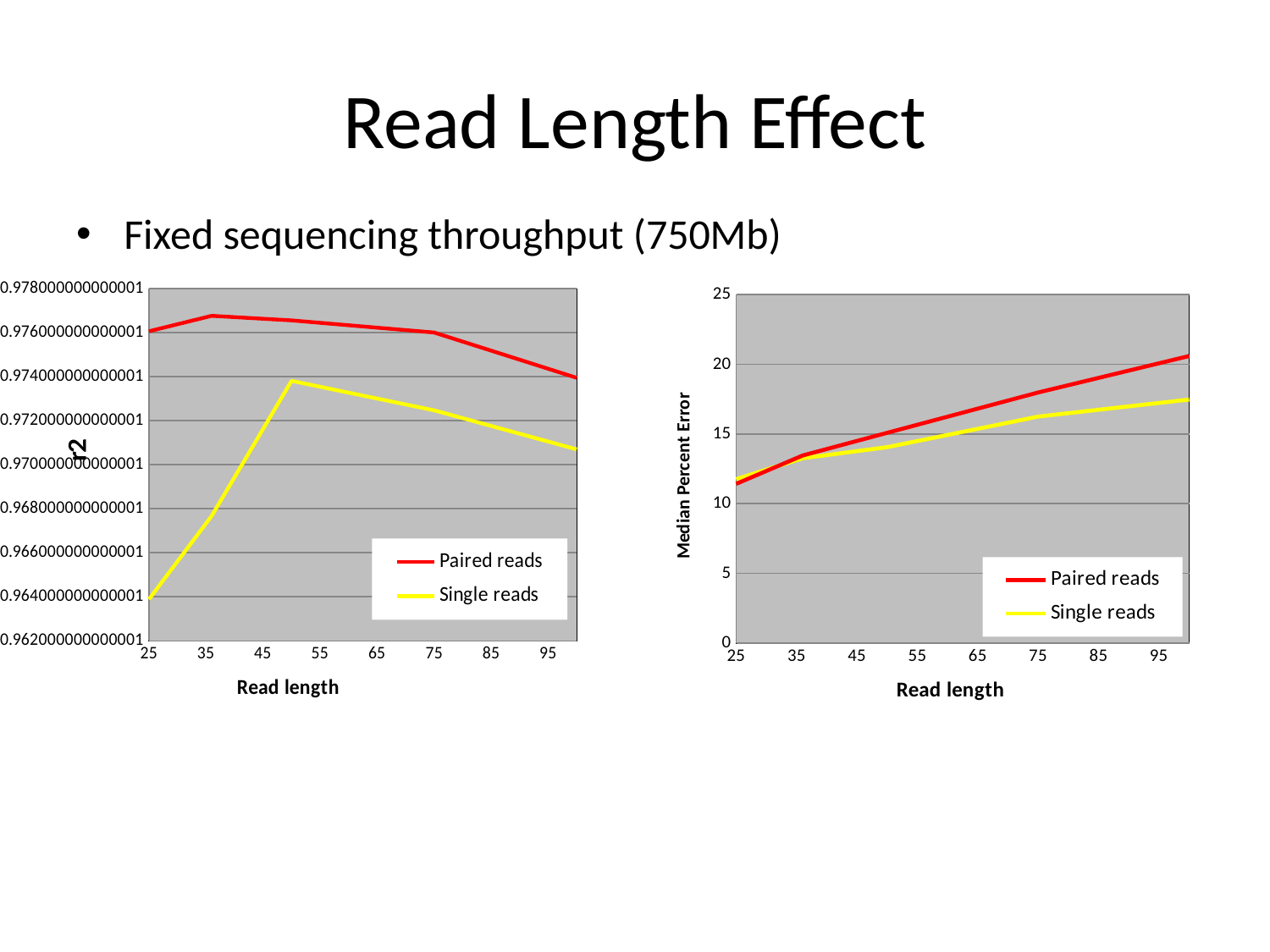
In the right chart (Median Percent Error), is the value for Single reads at read length 25 greater or less than 15? less In the right chart (Median Percent Error), is the value for Paired reads at read length 75 greater or less than 15? greater How many series does the legend of the left chart (r2 vs Read length) list? 2 In the left chart (r2 vs Read length), which series is higher at read length 25, Paired reads or Single reads? Paired reads In the right chart (Median Percent Error), does the Paired reads line rise or fall as read length increases? Rises What is the y-axis title of the right chart? Median Percent Error What kind of chart is the left chart (r2 vs Read length)? Line chart In the right chart (Median Percent Error), is the value for Paired reads at read length 25 greater or less than 10? greater What is the x-axis title of the left chart? Read length In the right chart (Median Percent Error), which series is higher at read length 95, Paired reads or Single reads? Paired reads In the left chart (r2 vs Read length), does the Paired reads line rise or fall between read length 35 and read length 95? Falls